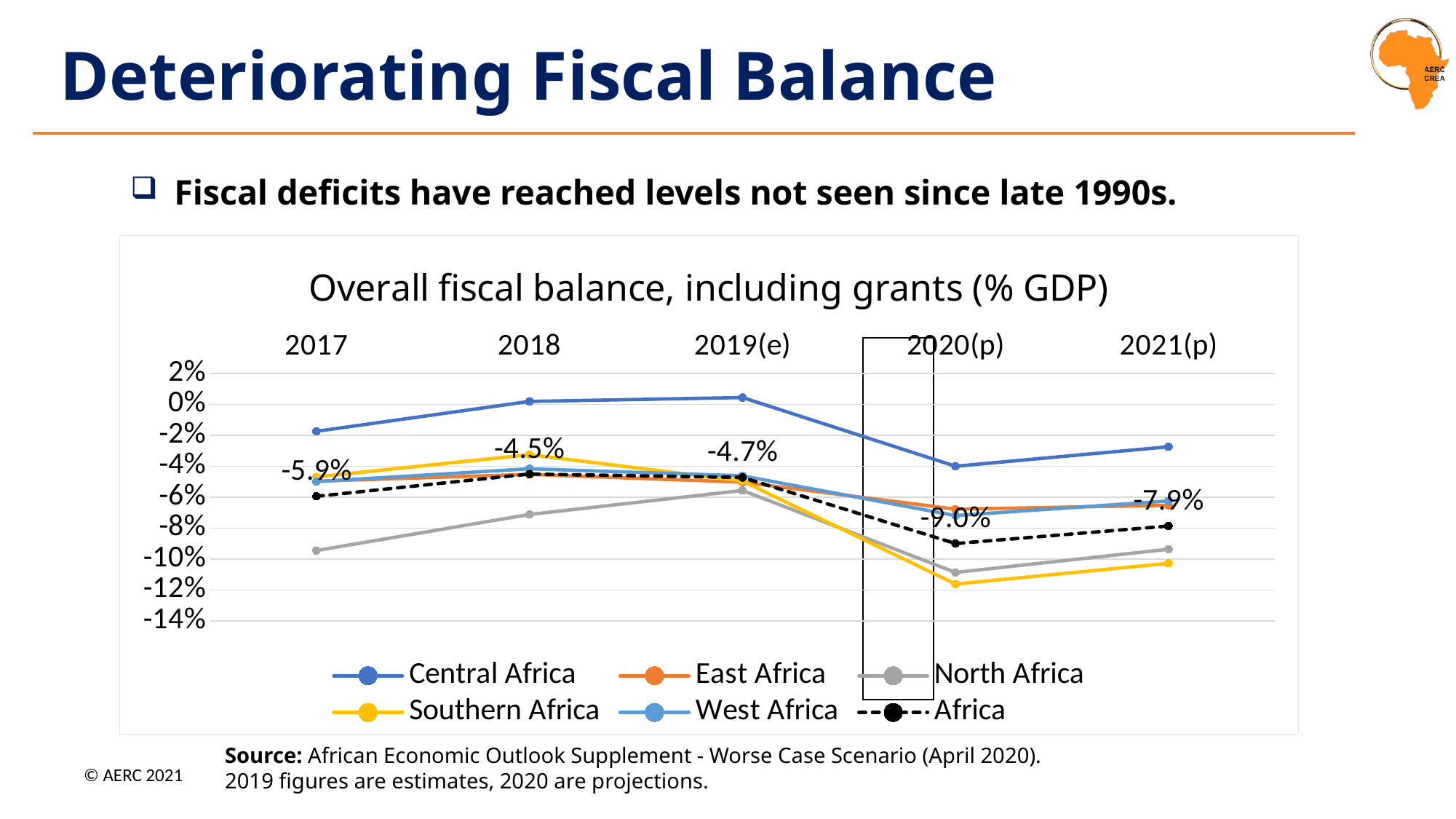
By how many percentage points does the Africa fiscal balance change between 2019(e) and 2020(p)? 4.3 percentage points What is the overall fiscal balance for Africa in 2020(p)? -9.0% How many years are shown on the x axis? 5 Which region has the highest fiscal balance in 2020(p)? Central Africa Is the value for North Africa in 2017 greater or less than -8%? less What kind of chart is shown on the slide? line chart What is the overall fiscal balance for Africa in 2021(p)? -7.9% Which region has the lowest fiscal balance in 2020(p)? Southern Africa How many series does the legend list? 6 Does the Africa line rise or fall between 2019(e) and 2020(p)? fall What is the overall fiscal balance for Africa in 2018? -4.5% What is the overall fiscal balance for Africa in 2017? -5.9%